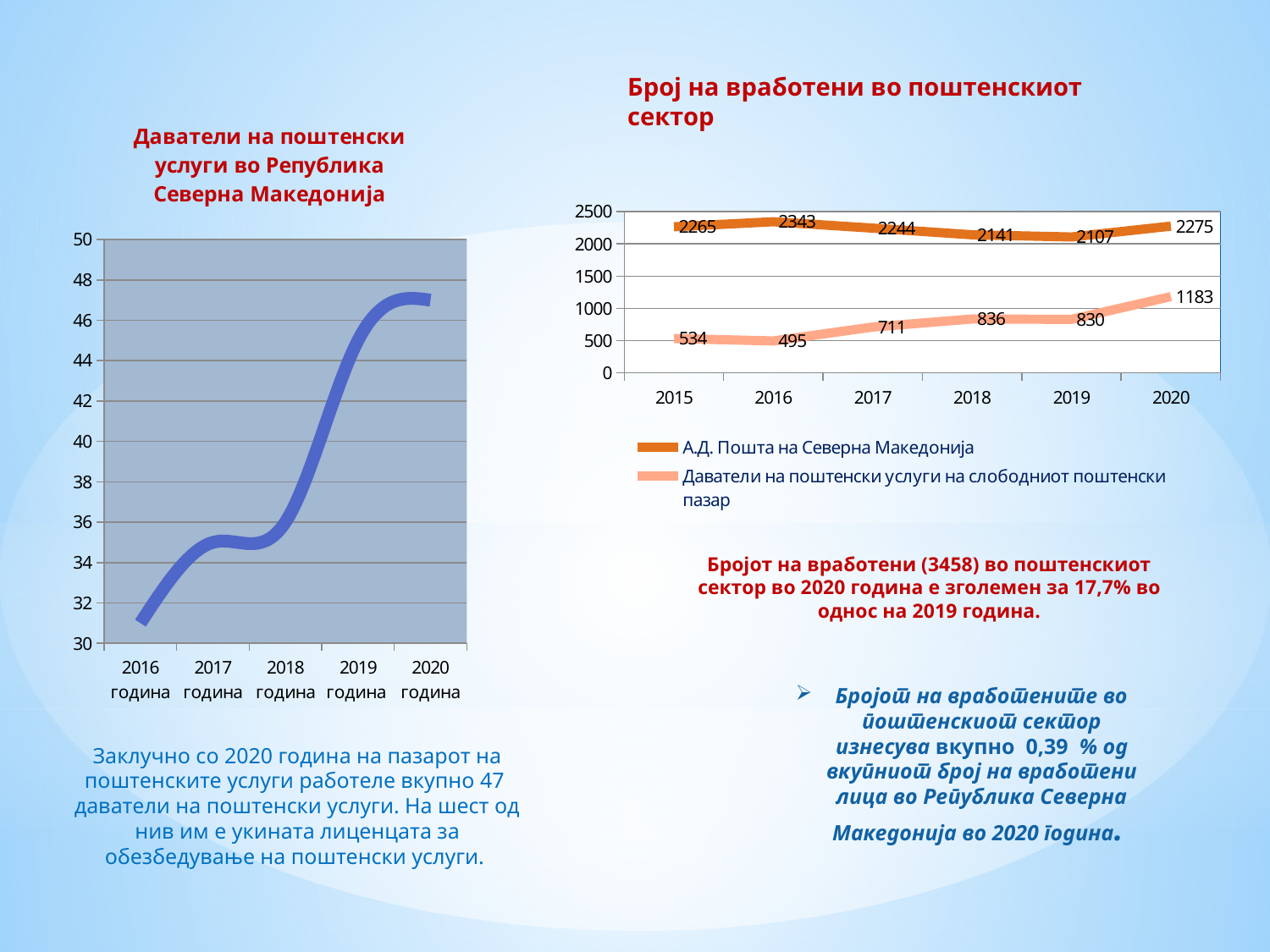
In the chart titled "Број на вработени во поштенскиот сектор", what is the value for Даватели на поштенски услуги на слободниот поштенски пазар in 2020? 1183 How many series does the legend of the chart titled "Број на вработени во поштенскиот сектор" list? 2 What kind of chart is the chart titled "Даватели на поштенски услуги во Република Северна Македонија"? line chart In the chart titled "Број на вработени во поштенскиот сектор", what is the value for А.Д. Пошта на Северна Македонија in 2016? 2343 In the chart titled "Број на вработени во поштенскиот сектор", in which year is the value for Даватели на поштенски услуги на слободниот поштенски пазар lowest? 2016 In the chart titled "Број на вработени во поштенскиот сектор", in which year is the value for А.Д. Пошта на Северна Македонија highest? 2016 In the chart titled "Број на вработени во поштенскиот сектор", what is the difference between the 2020 and 2019 values for Даватели на поштенски услуги на слободниот поштенски пазар? 353 In the chart titled "Даватели на поштенски услуги во Република Северна Македонија", is the value for 2020 година greater or less than 44? greater In the chart titled "Број на вработени во поштенскиот сектор", which series has the larger value in 2018? А.Д. Пошта на Северна Македонија In the chart titled "Даватели на поштенски услуги во Република Северна Македонија", do the values generally rise or fall from 2016 to 2020? rise In the chart titled "Даватели на поштенски услуги во Република Северна Македонија", is the value for 2016 година greater or less than 34? less How many years are shown on the x axis of the chart titled "Број на вработени во поштенскиот сектор"? 6